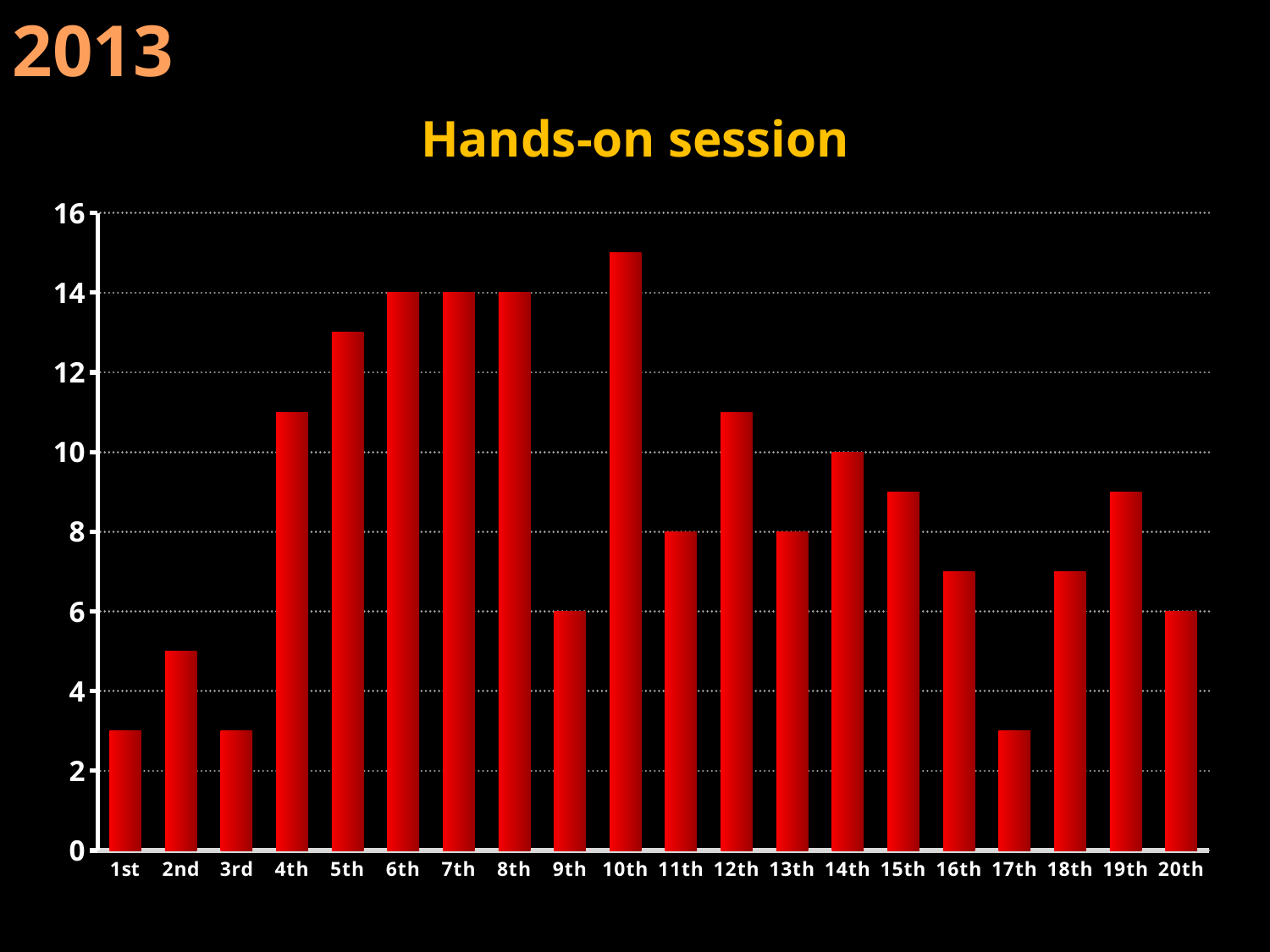
What is the difference between the values for 6th and 11th? 6 How many categories are shown on the x axis? 20 What is the value for 6th? 14 What is the title of the chart? Hands-on session What is the value for 11th? 8 Which category has the highest value? 10th What is the value for 9th? 6 Is the value for 10th greater or less than 14? greater Which is larger, the value for 14th or the value for 9th? 14th What is the value for 14th? 10 Is the value for 17th greater or less than 4? less What kind of chart is shown on the slide? bar chart